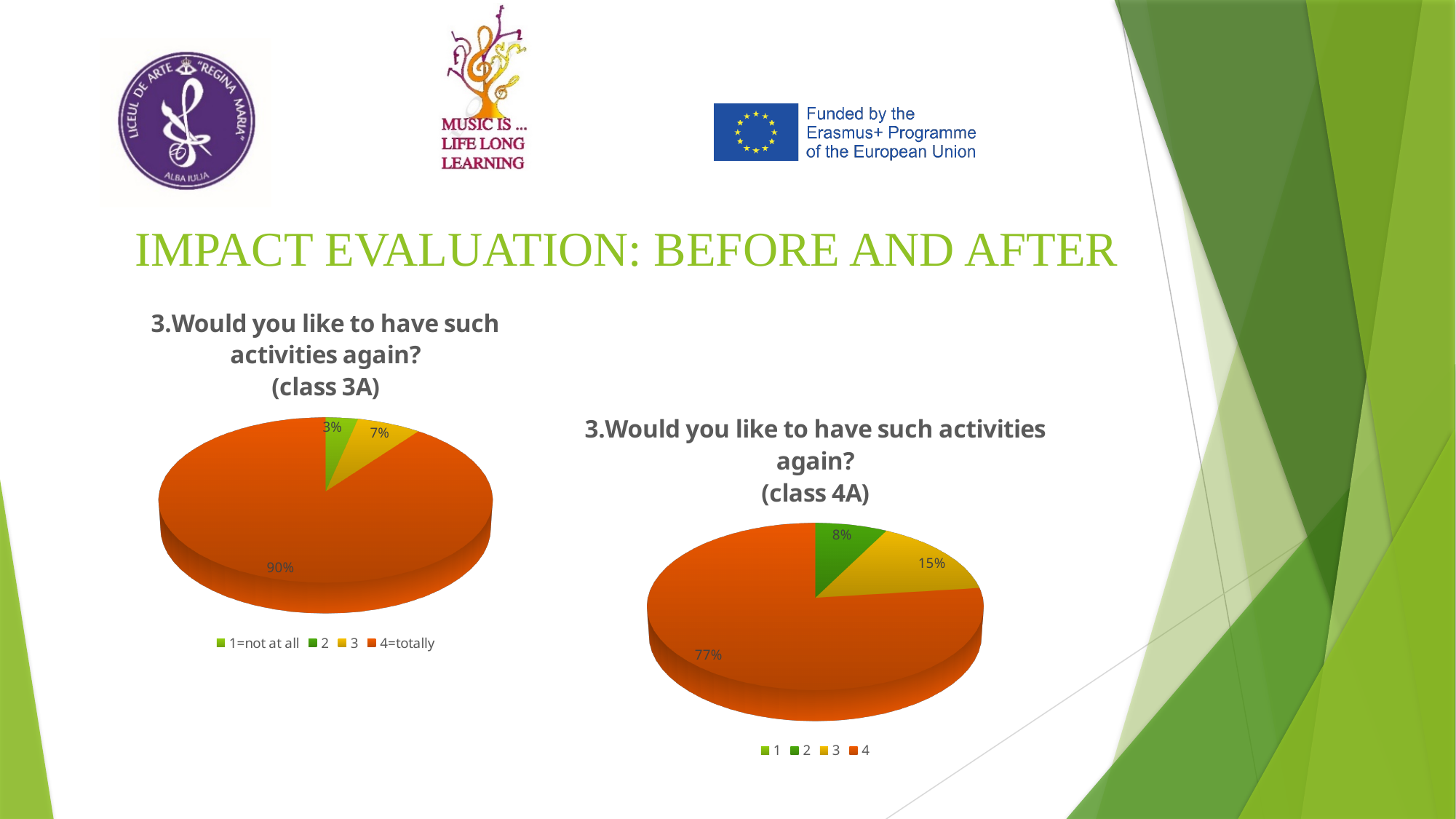
In the class 4A chart, what is the difference between the slices for category 4 and category 3? 62% In the class 4A chart, which category has the largest slice? 4 In the class 3A chart, what percentage is shown for the slice '4=totally'? 90% In the class 4A chart, what percentage is shown for category 2? 8% What kind of chart is used on the slide for class 3A and class 4A? Pie chart In the class 4A chart, what percentage is shown for category 4? 77% In the class 3A chart, what is the value of the smallest slice? 3% In the class 3A chart, what percentage is shown for the yellow slice (category 3)? 7% How many entries does the legend of the class 3A chart list? 4 In the class 3A chart, what is the difference between the '4=totally' slice and the 7% slice? 83% Which is larger: the '4=totally' slice in the class 3A chart or the category 4 slice in the class 4A chart? Class 3A (90%) In the class 4A chart, what percentage is shown for category 3? 15%